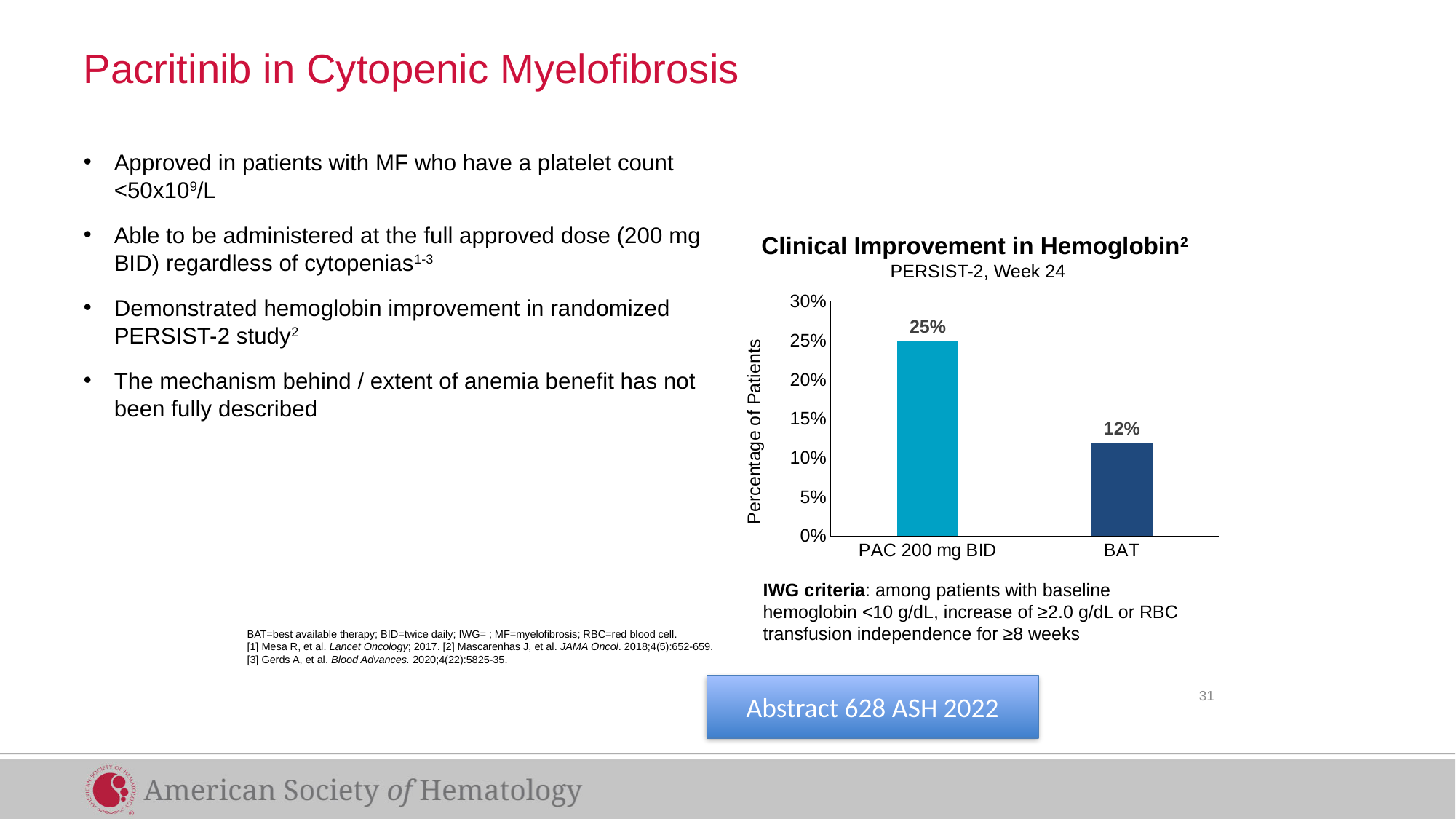
How many treatment arms are shown in the chart? 2 What is the difference in percentage points between PAC 200 mg BID and BAT? 13% Is the value for PAC 200 mg BID greater or less than 20%? greater What percentage of patients had clinical improvement in hemoglobin with PAC 200 mg BID? 25% Which treatment arm has the lower percentage of patients with clinical improvement in hemoglobin? BAT What type of chart is used to show clinical improvement in hemoglobin? Bar chart What is the title of the chart? Clinical Improvement in Hemoglobin What percentage of patients had clinical improvement in hemoglobin with BAT? 12% Is the value for BAT greater or less than 15%? less Which treatment arm has the higher percentage of patients with clinical improvement in hemoglobin? PAC 200 mg BID What is the label of the y-axis of the chart? Percentage of Patients What is the maximum value shown on the y-axis of the chart? 30%